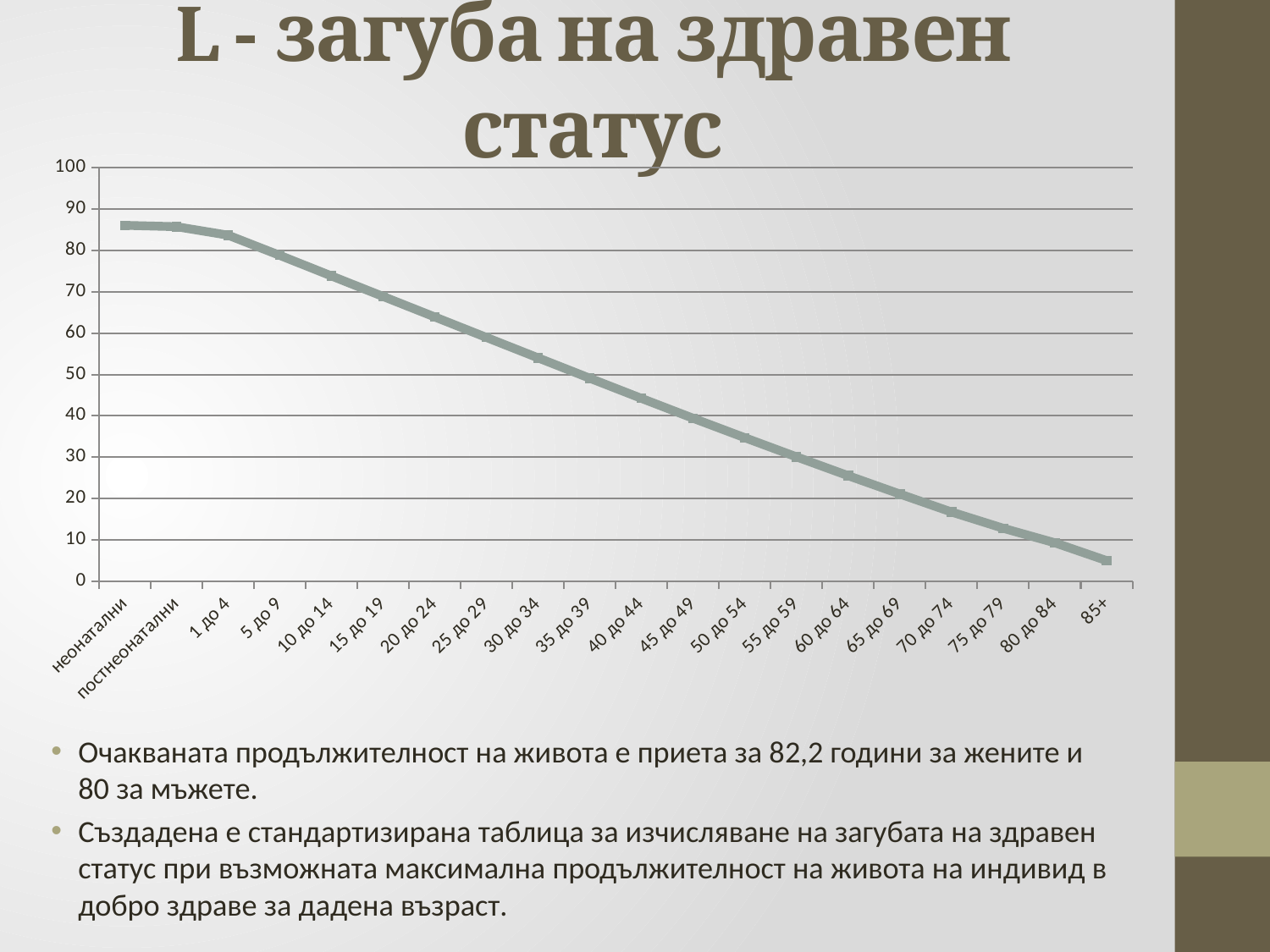
Is the value for 70 до 74 greater or less than 20? less Is the value for 30 до 34 greater or less than 50? greater Which category has the lowest value? 85+ What is the title of the slide containing the chart? L - загуба на здравен статус Do the values rise or fall along the x axis from неонатални to 85+? fall Is the value for 60 до 64 greater or less than 30? less Which is larger, the value for 20 до 24 or the value for 50 до 54? 20 до 24 What kind of chart is shown on the slide? line chart How many age categories are plotted along the x axis? 20